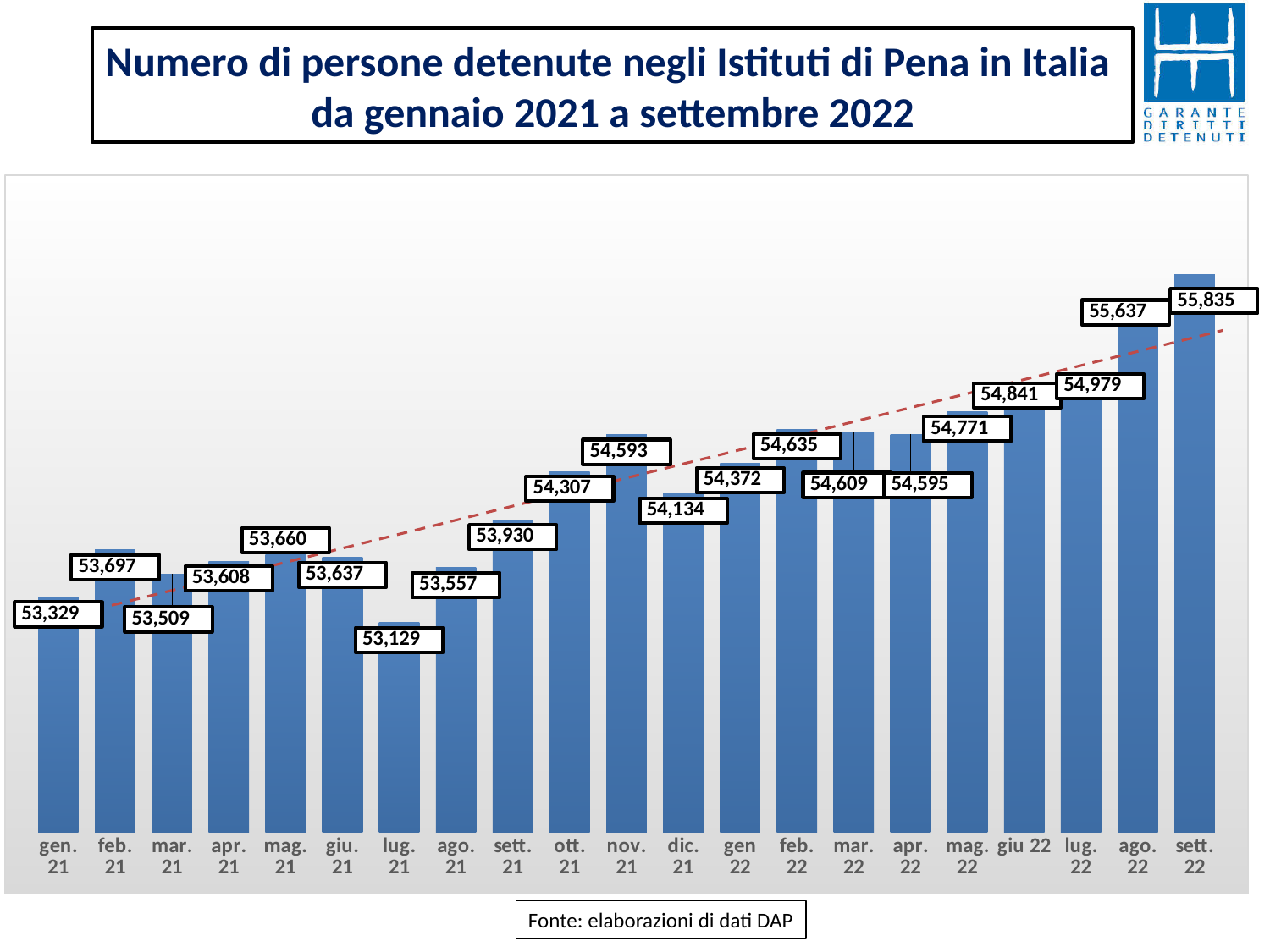
What is the number of detained persons shown for gen. 21? 53,329 What kind of chart is shown on the slide? bar chart What value is shown for dic. 21? 54,134 What value is shown for lug. 21? 53,129 What is the difference between the values for nov. 21 and dic. 21? 459 Which is larger, the value for feb. 22 or the value for apr. 22? feb. 22 What is the difference between the values for sett. 22 and gen. 21? 2,506 Which month has the highest number of detained persons? sett. 22 Do the values generally rise or fall from gen. 21 to sett. 22? rise How many months (bars) are shown in the chart? 21 Which month has the lowest number of detained persons? lug. 21 What value is shown for sett. 22? 55,835